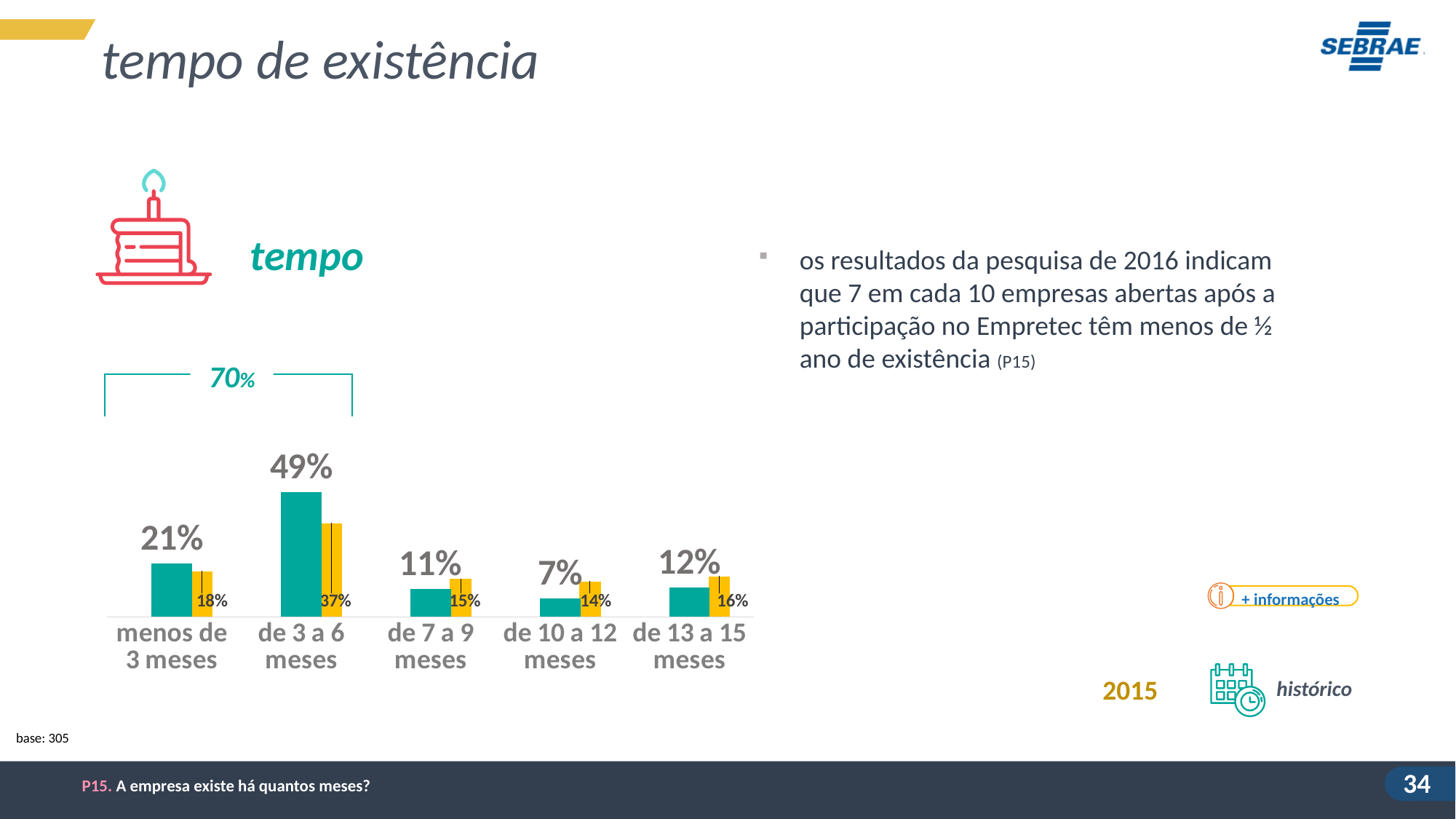
For 'de 7 a 9 meses', which is larger: the teal bar or the yellow bar? the yellow bar Which category has the highest teal bar value? de 3 a 6 meses How many categories are shown on the x axis of the chart? 5 What is the value of the yellow bar for 'de 3 a 6 meses'? 37% What is the value of the teal bar for 'menos de 3 meses'? 21% What kind of chart is shown on the slide? bar chart What is the difference between the teal bar values for 'de 3 a 6 meses' and 'menos de 3 meses'? 28% What is the value of the yellow bar for 'de 10 a 12 meses'? 14% Which category has the lowest teal bar value? de 10 a 12 meses What is the value of the teal bar for 'de 3 a 6 meses'? 49% What is the base (sample size) noted for the chart? 305 What combined percentage is shown by the bracket above the first two categories? 70%